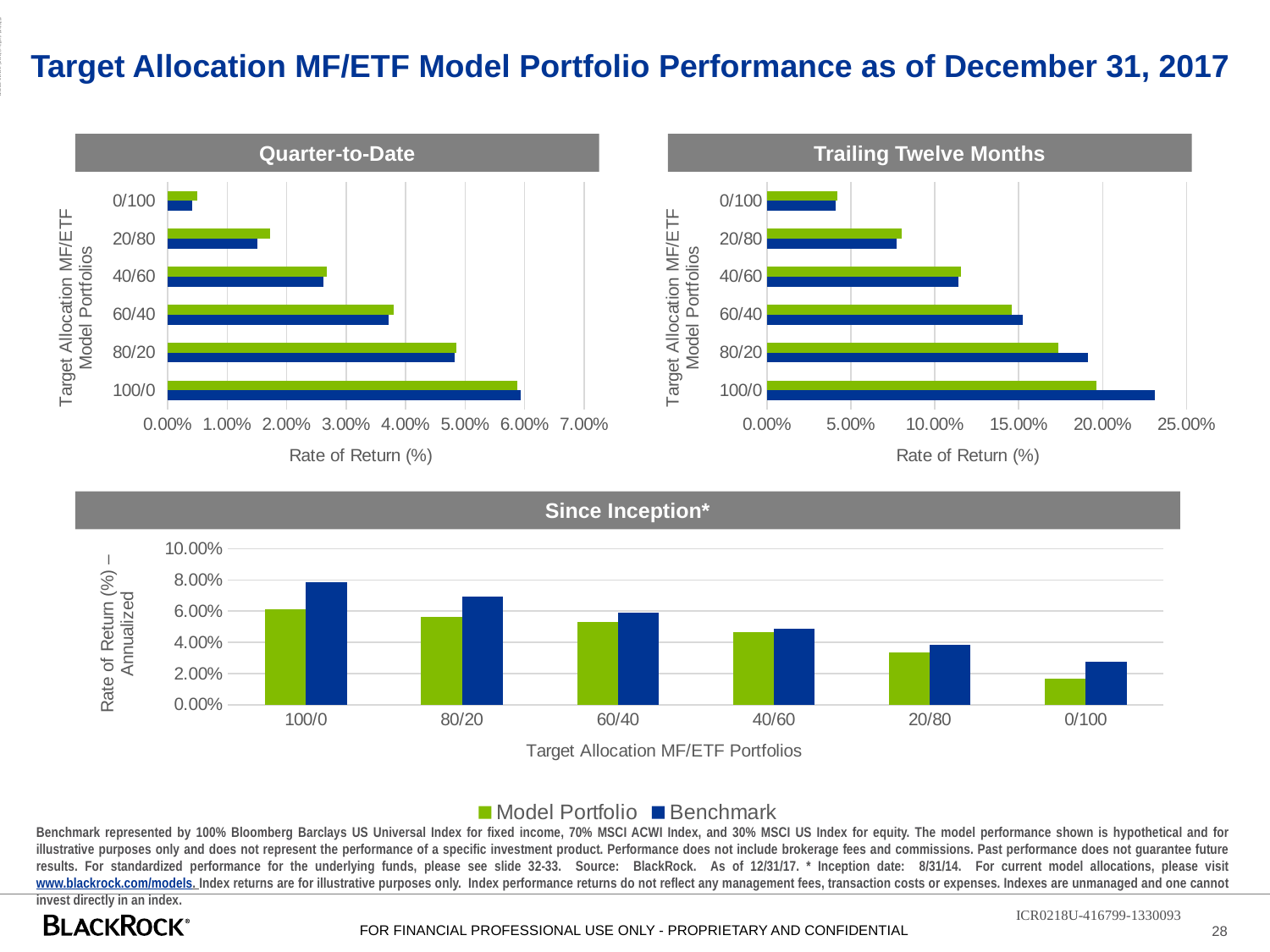
In the Trailing Twelve Months chart, is the Benchmark value for 100/0 greater or less than 20.00%? greater In the Trailing Twelve Months chart, for the 100/0 portfolio, which is larger: the Model Portfolio or the Benchmark? Benchmark In the Since Inception chart, is the Benchmark value for 100/0 greater or less than 6.00%? greater How many series does the legend list for the charts on this slide? 2 In the Trailing Twelve Months chart, is the Model Portfolio value for 0/100 greater or less than 5.00%? less In the Since Inception chart, do the values rise or fall moving from 100/0 to 0/100 along the x axis? fall What is the x-axis label of the Since Inception chart? Target Allocation MF/ETF Portfolios In the Quarter-to-Date chart, which portfolio has the highest Model Portfolio rate of return? 100/0 What kind of chart is the Quarter-to-Date chart? bar chart In the Quarter-to-Date chart, which portfolio has the lowest Model Portfolio rate of return? 0/100 How many portfolio categories are shown in the Trailing Twelve Months chart? 6